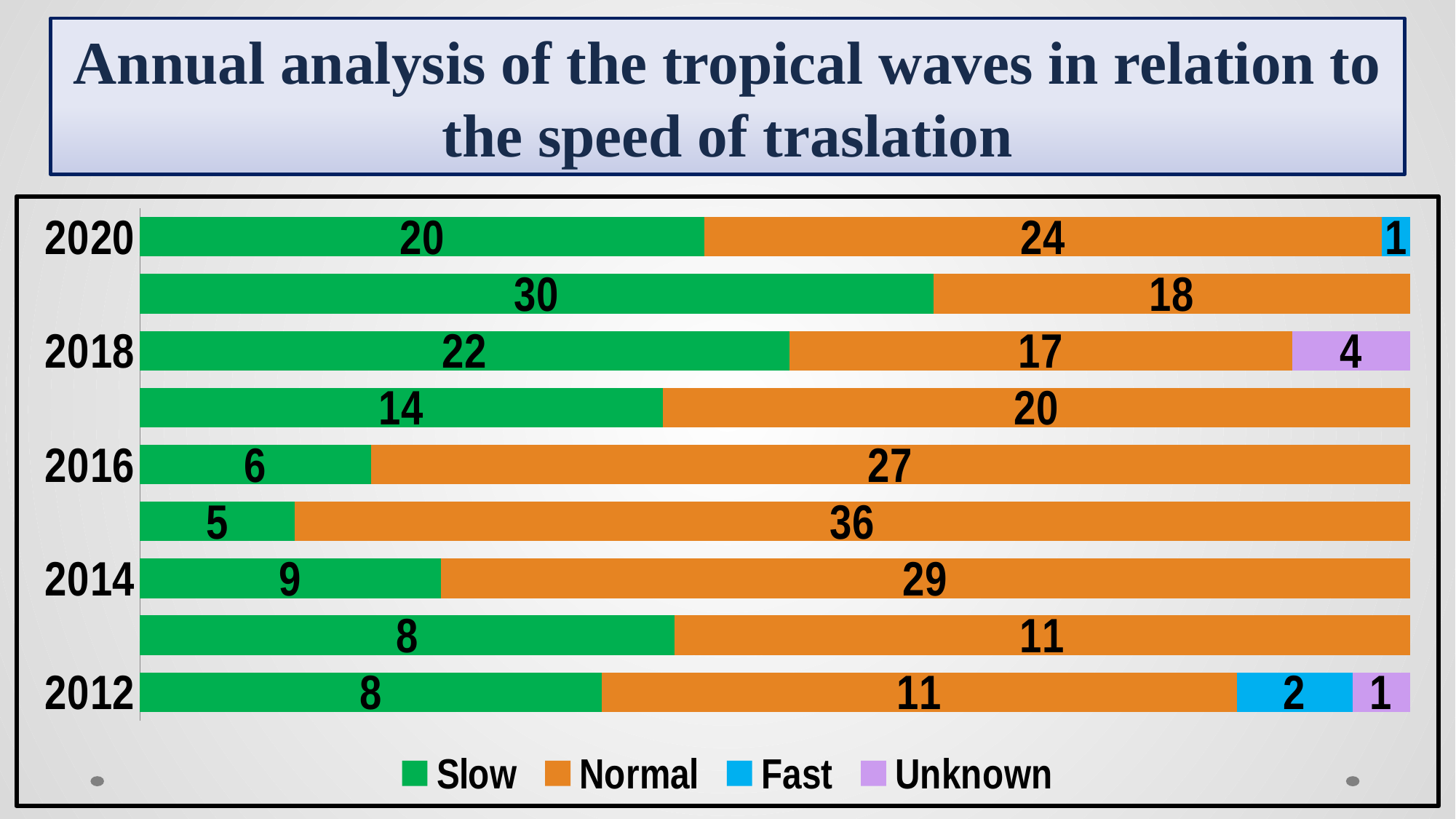
Among the labeled years, which year has the highest Slow value? 2018 What is the Fast value for 2012? 2 Which is larger for 2018, the Slow value or the Normal value? Slow Among the labeled years, which year has the lowest Slow value? 2016 What is the Slow value for 2020? 20 What is the Normal value for 2016? 27 What is the Unknown value for 2018? 4 What is the difference between the Normal value and the Slow value for 2014? 20 What is the total of the stacked bar for 2020? 45 How many series does the legend list? 4 What is the total of the stacked bar for 2012? 22 What kind of chart is shown on the slide? Stacked bar chart